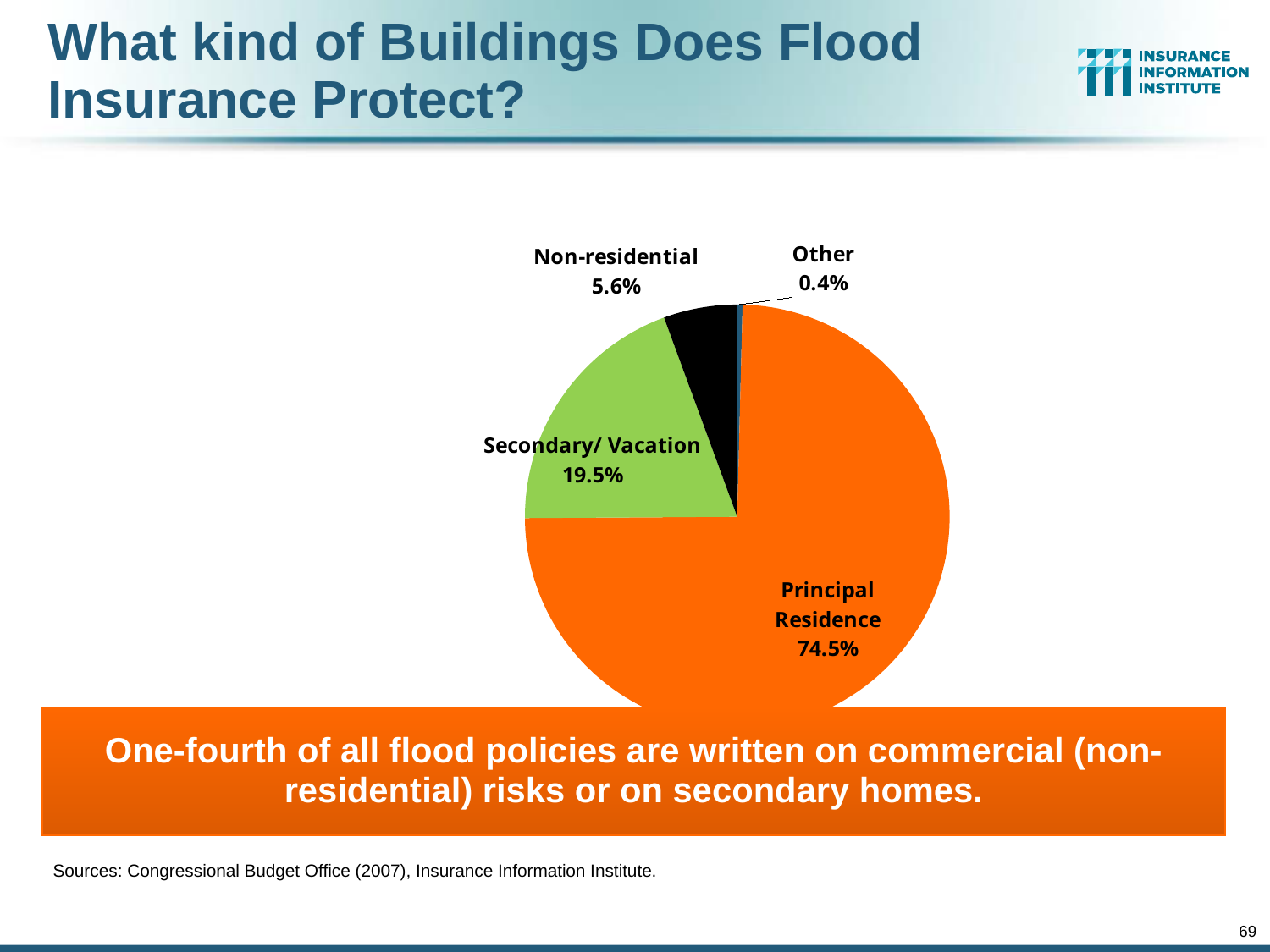
What share of the pie is Principal Residence? 74.5% How many categories are shown in the pie chart? 4 Which category has the largest slice of the pie? Principal Residence What share of the pie is Secondary/ Vacation? 19.5% Which category has the smallest slice of the pie? Other What is the value for Other? 0.4% What colour is the Principal Residence slice? orange What is the difference between the Secondary/ Vacation share and the Non-residential share? 13.9% What kind of chart is shown on the slide? pie chart What is the value for Non-residential? 5.6% What is the difference between the Principal Residence share and the Secondary/ Vacation share? 55% Which is larger, the Non-residential slice or the Secondary/ Vacation slice? Secondary/ Vacation